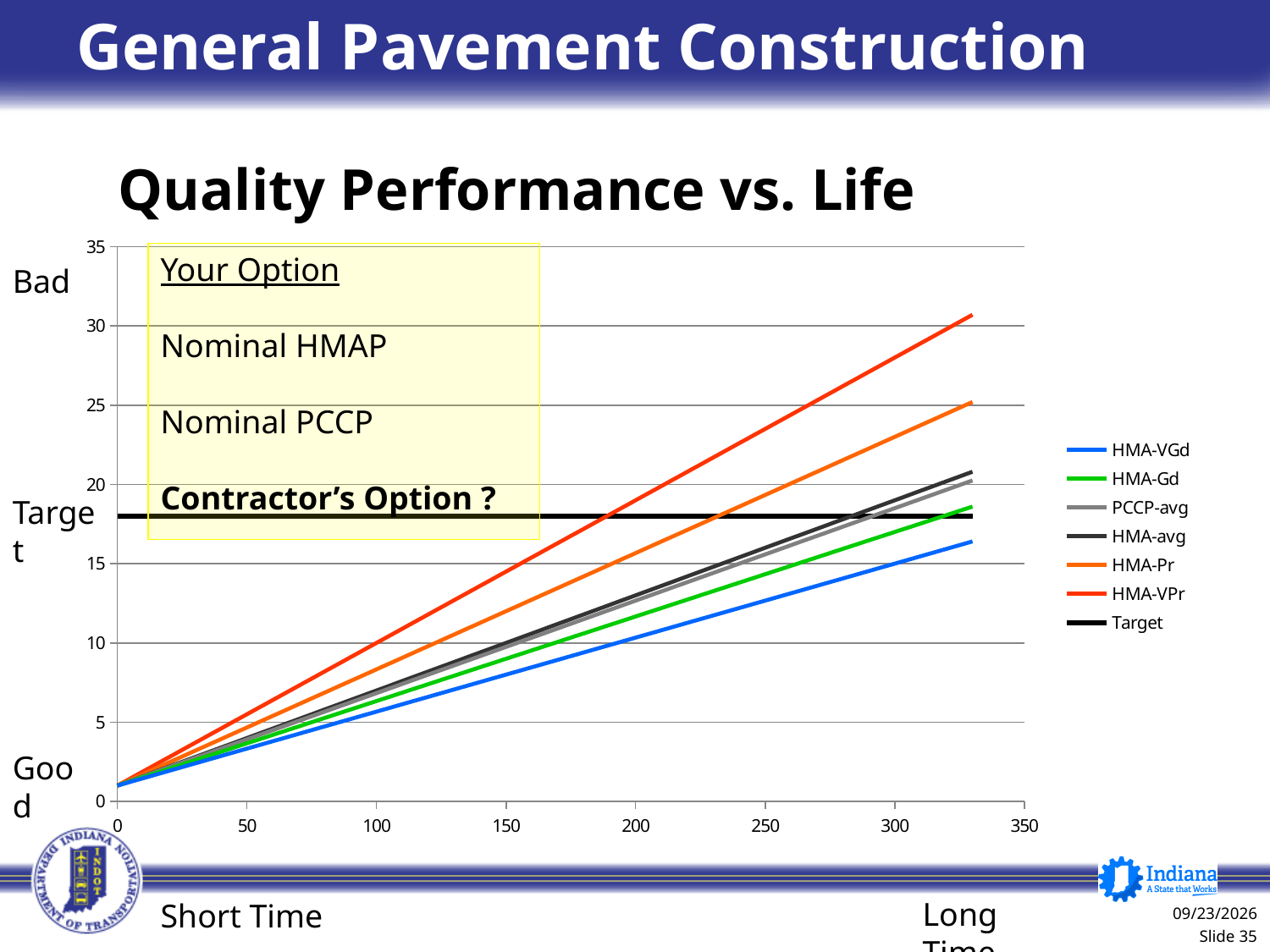
Is the value of the HMA-Pr line at x = 300 greater or less than 20? greater Is the Target line greater or less than 15 on the y axis? greater At x = 300, which series has the larger value, HMA-Pr or HMA-Gd? HMA-Pr What colour is the Target line in the chart? Black How many series does the chart legend list? 7 Is the value of the HMA-VPr line at x = 300 greater or less than 25? greater What kind of chart is shown on the slide? Line chart What is the title of the chart? Quality Performance vs. Life Do the values of the HMA-VPr series rise or fall as the x axis increases? Rise Which series reaches the highest value at the right end of the chart? HMA-VPr Which series has the lowest value at the right end of the chart? HMA-VGd